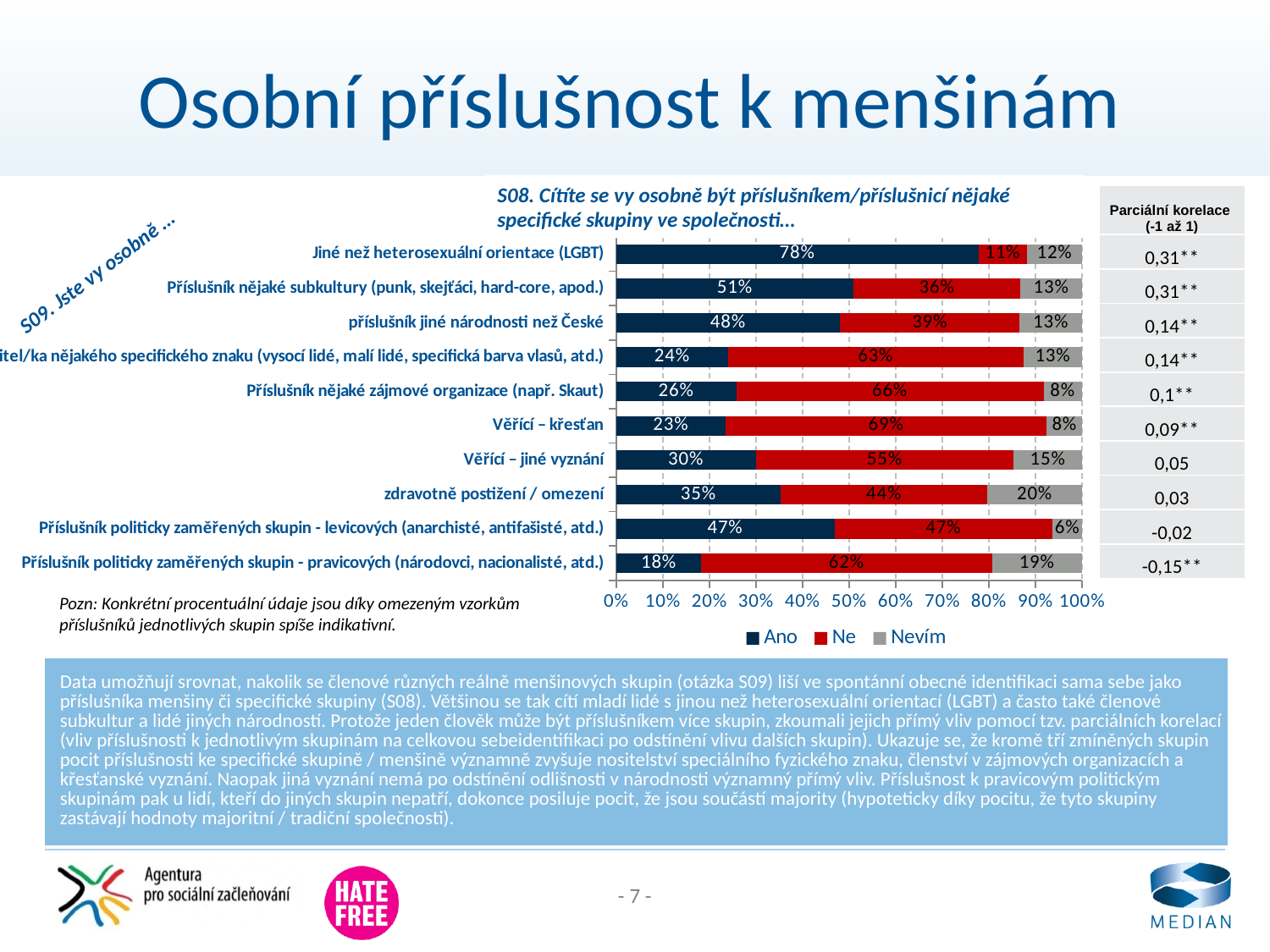
What kind of chart is shown on the slide? Stacked bar chart Which has a larger 'Ne' value: 'Věřící – jiné vyznání' or 'Příslušník nějaké zájmové organizace (např. Skaut)'? Příslušník nějaké zájmové organizace (např. Skaut) What is the 'Nevím' value for 'zdravotně postižení / omezení'? 20% Which category has the lowest 'Ano' value? Příslušník politicky zaměřených skupin - pravicových (národovci, nacionalisté, atd.) What is the difference between the 'Ano' values for 'Příslušník nějaké subkultury (punk, skejťáci, hard-core, apod.)' and 'příslušník jiné národnosti než České'? 3 percentage points Which category has the highest 'Ano' value? Jiné než heterosexuální orientace (LGBT) What is the 'Ne' value for 'Věřící – křesťan'? 69% How many series does the legend list? 3 What is the total of the 'Ano' and 'Ne' values for 'Příslušník politicky zaměřených skupin - levicových (anarchisté, antifašisté, atd.)'? 94% Which series is shown in red in the chart? Ne What percentage of respondents with 'Jiné než heterosexuální orientace (LGBT)' answered 'Ano'? 78% How many categories are shown on the chart? 10